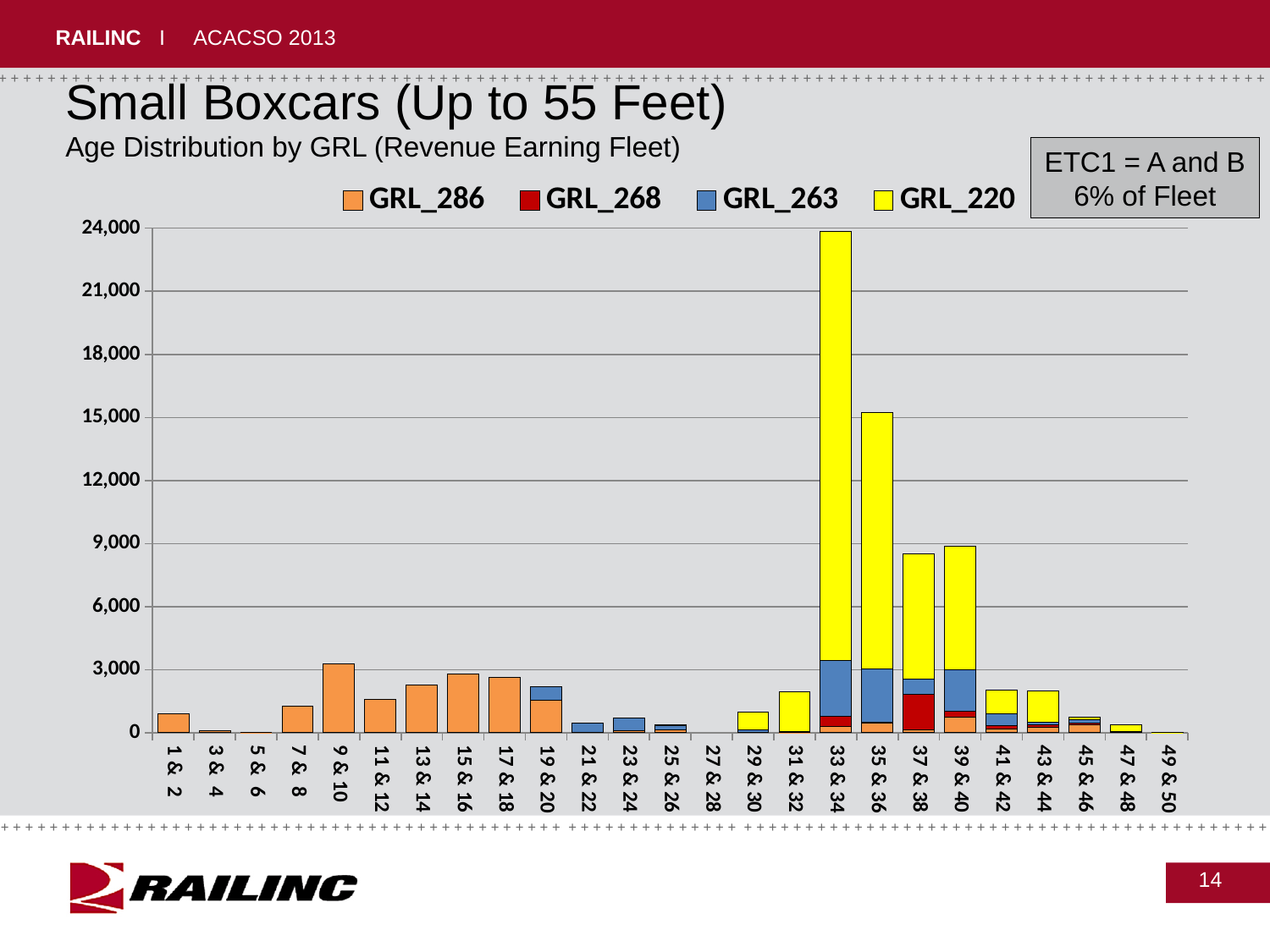
Which bar is taller, 33 & 34 or 35 & 36? 33 & 34 How many age-group categories are shown along the x axis? 25 What kind of chart is shown on the slide? Stacked bar chart Which age group has the tallest bar? 33 & 34 Is the total for the 37 & 38 age group greater or less than 6,000? greater Which series makes up most of the 33 & 34 bar? GRL_220 Is the total for the 33 & 34 age group greater or less than 21,000? greater Which series is shown in yellow in the legend? GRL_220 Which bar is taller, 13 & 14 or 11 & 12? 13 & 14 How many series does the legend list? 4 Is the total for the 1 & 2 age group greater or less than 3,000? less